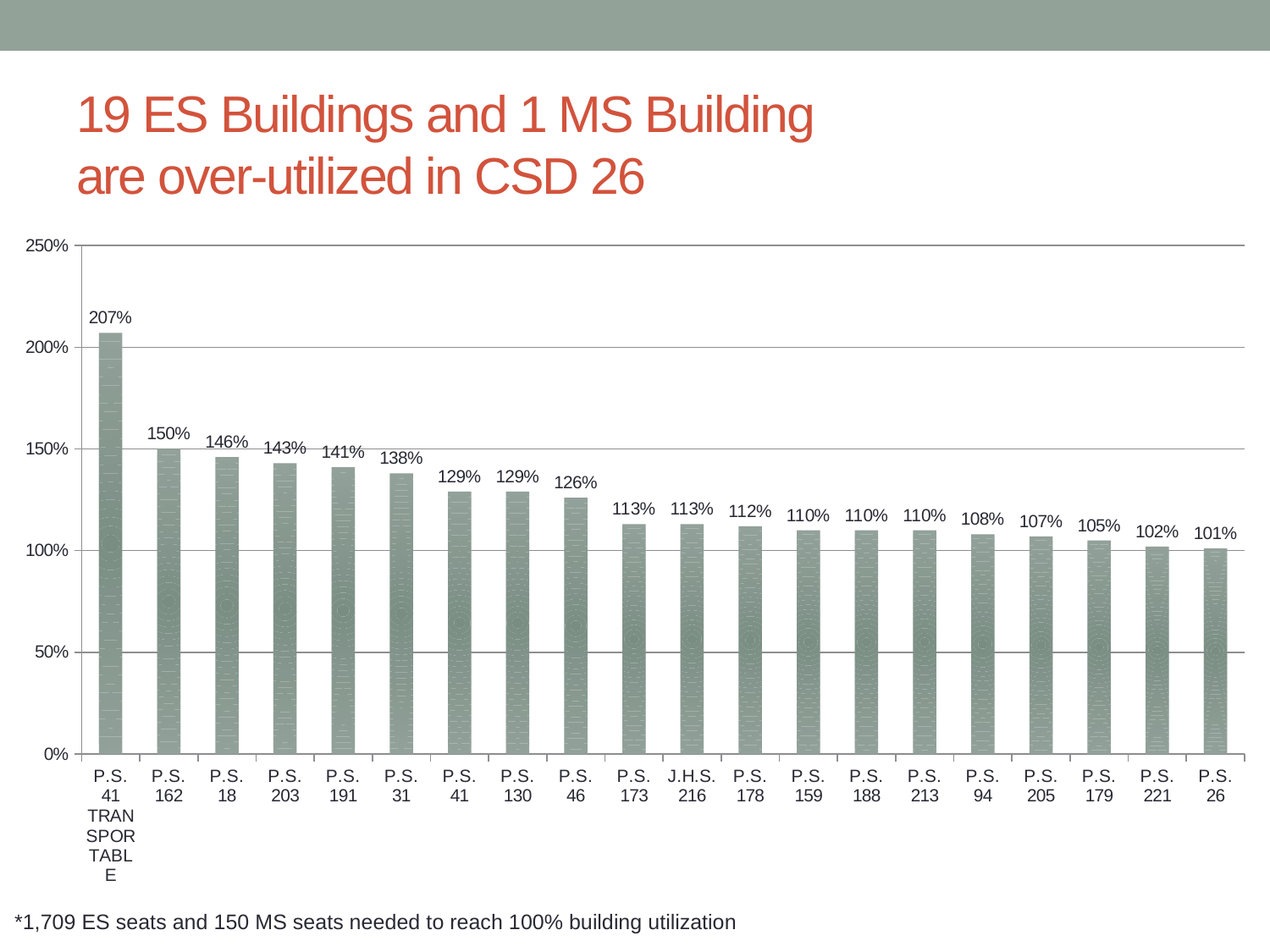
Which building has the lowest utilization? P.S. 26 What is the difference between the utilization of P.S. 18 and P.S. 221? 44% What is the utilization value for J.H.S. 216? 113% What is the utilization value for P.S. 162? 150% Which building has the highest utilization? P.S. 41 TRANSPORTABLE What kind of chart is shown on the slide? bar chart Do the values rise or fall from left to right along the x axis? fall How many buildings are shown on the chart? 20 Is the value for P.S. 31 greater or less than 150%? less What is the difference between the utilization of P.S. 41 TRANSPORTABLE and P.S. 162? 57% What is the utilization value for P.S. 26? 101% Which has a higher utilization, P.S. 203 or P.S. 46? P.S. 203